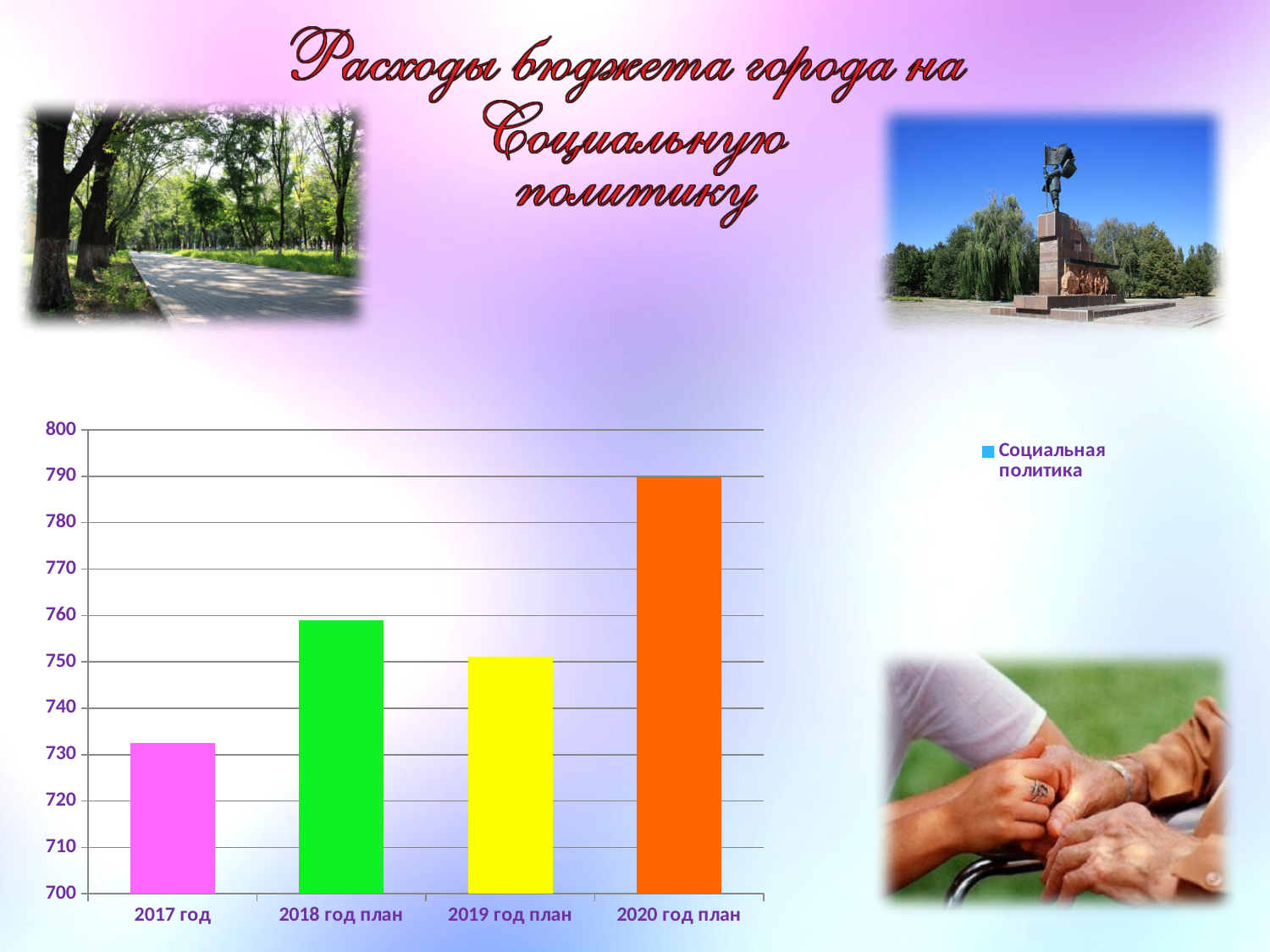
Which category has the lowest bar in the chart? 2017 год What kind of chart is shown on the slide? bar chart Does the value rise or fall from 2018 год план to 2019 год план? fall Which category has the highest bar in the chart? 2020 год план How many series does the chart legend list? 1 Which is larger, the value for 2018 год план or the value for 2019 год план? 2018 год план Is the value for 2019 год план greater or less than 760? less How many categories are shown on the x axis of the chart? 4 Is the value for 2017 год greater or less than 740? less What is the series name shown in the chart legend? Социальная политика Is the value for 2018 год план greater or less than 750? greater